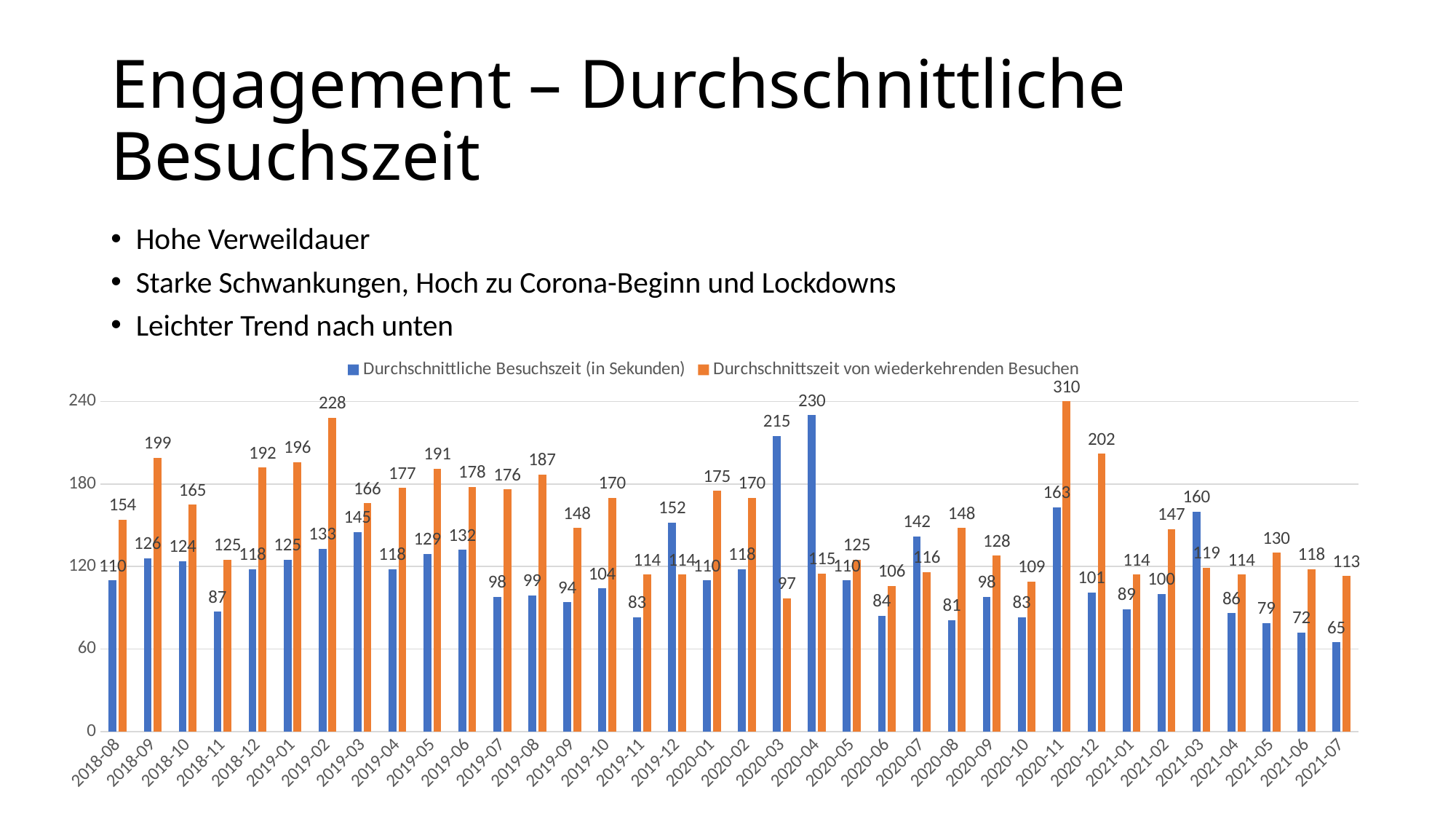
Which colour represents Durchschnittszeit von wiederkehrenden Besuchen in the chart? orange What is the difference between Durchschnittszeit von wiederkehrenden Besuchen and Durchschnittliche Besuchszeit (in Sekunden) in 2020-11? 147 What is the value of Durchschnittliche Besuchszeit (in Sekunden) for 2020-03? 215 What type of chart is shown on the slide? bar chart In which month is Durchschnittliche Besuchszeit (in Sekunden) highest? 2020-04 How many months (categories) are plotted on the x axis? 36 How many series does the legend list? 2 What is the value of Durchschnittszeit von wiederkehrenden Besuchen for 2019-02? 228 In which month is Durchschnittszeit von wiederkehrenden Besuchen lowest? 2020-03 In which month is Durchschnittliche Besuchszeit (in Sekunden) lowest? 2021-07 In which month is Durchschnittszeit von wiederkehrenden Besuchen highest? 2020-11 In 2020-03, which series has the larger value: Durchschnittliche Besuchszeit (in Sekunden) or Durchschnittszeit von wiederkehrenden Besuchen? Durchschnittliche Besuchszeit (in Sekunden)